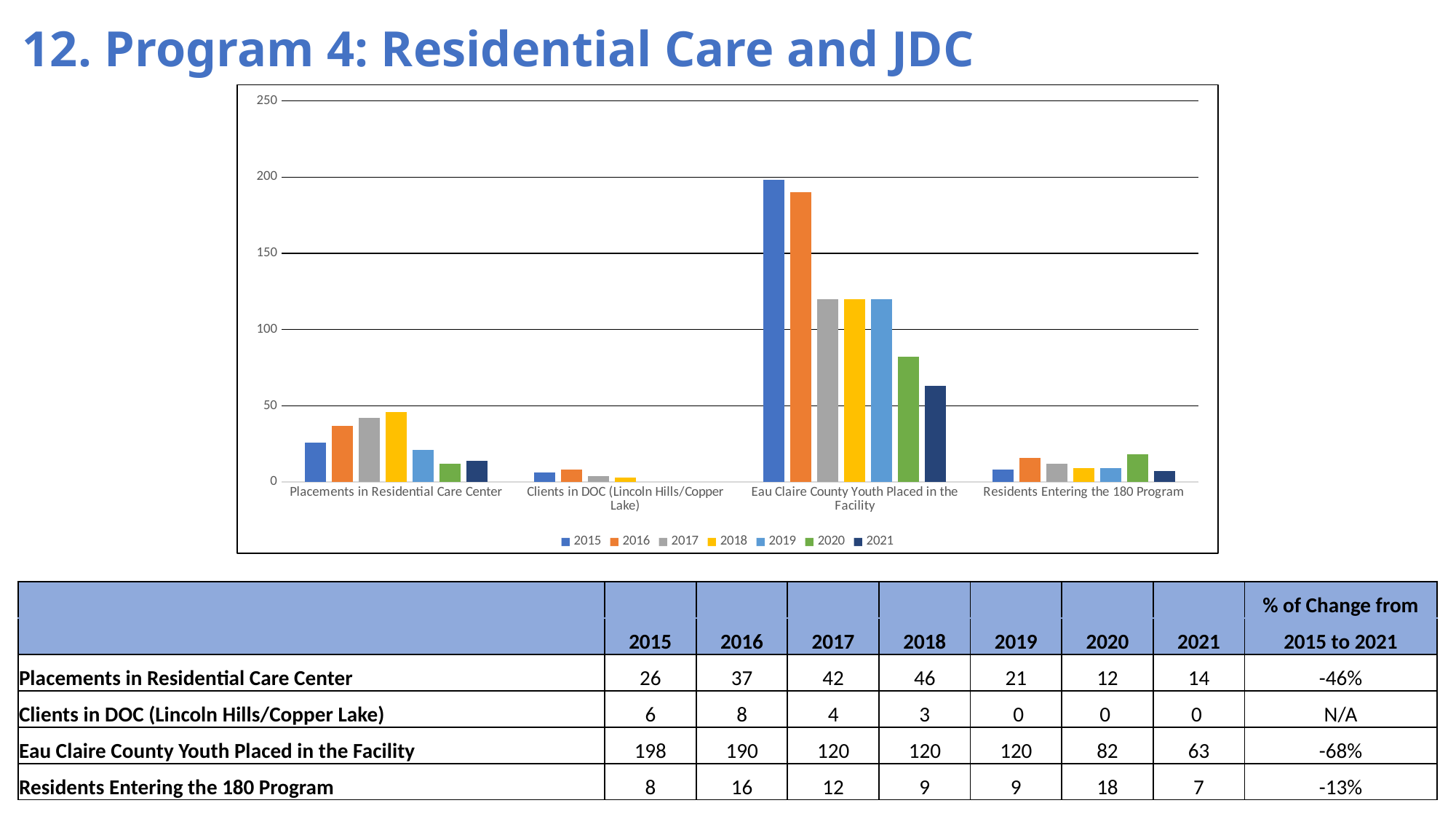
How many series does the chart legend list? 7 How many categories are shown on the x axis of the chart? 4 What is the value for Placements in Residential Care Center in 2018? 46 What is the value for Residents Entering the 180 Program in 2020? 18 Which year has the lowest value for Placements in Residential Care Center? 2020 Do the values for Eau Claire County Youth Placed in the Facility rise or fall from 2015 to 2021? fall What kind of chart is shown on the slide? bar chart Is the value for Eau Claire County Youth Placed in the Facility in 2020 greater or less than 100? less Which category has the highest value in 2016? Eau Claire County Youth Placed in the Facility What is the value for Eau Claire County Youth Placed in the Facility in 2015? 198 What is the difference between the 2015 and 2021 values for Eau Claire County Youth Placed in the Facility? 135 Which is larger: Placements in Residential Care Center in 2017 or Residents Entering the 180 Program in 2017? Placements in Residential Care Center